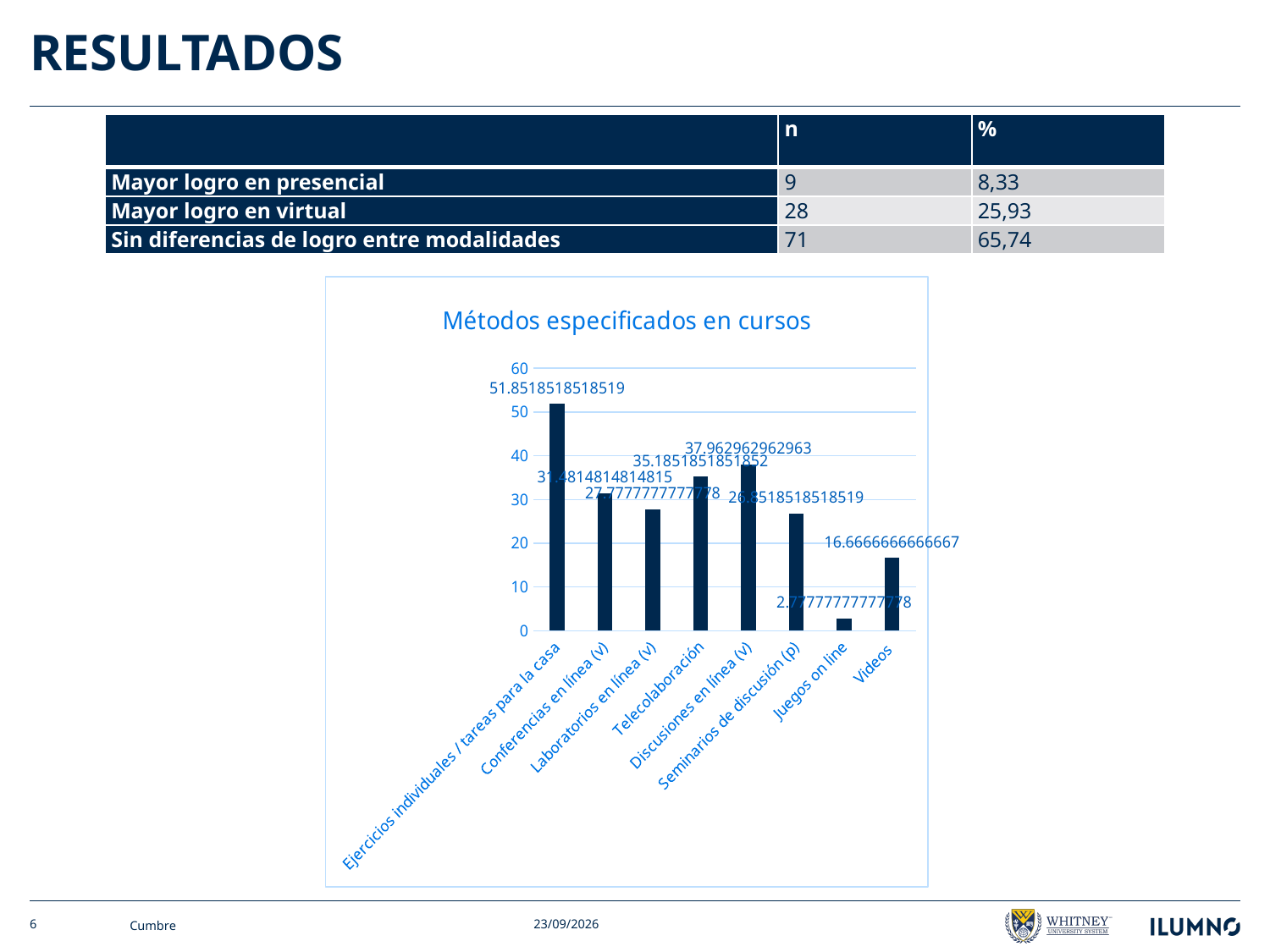
What is the title of the chart on the slide? Métodos especificados en cursos What is the value for "Seminarios de discusión (p)" in the chart? 26.8518518518519 Which has a larger value in the chart, "Telecolaboración" or "Videos"? Telecolaboración What is the value for "Ejercicios individuales / tareas para la casa" in the chart? 51.8518518518519 What type of chart is shown under the title "Métodos especificados en cursos"? bar chart What is the value for "Juegos on line" in the chart? 2.77777777777778 Which category has the lowest value in the chart "Métodos especificados en cursos"? Juegos on line Which category has the highest value in the chart "Métodos especificados en cursos"? Ejercicios individuales / tareas para la casa Is the value for "Laboratorios en línea (v)" greater or less than 20? greater How many categories are plotted in the chart "Métodos especificados en cursos"? 8 What is the value for "Videos" in the chart? 16.6666666666667 What is the value for "Discusiones en línea (v)" in the chart? 37.962962962963